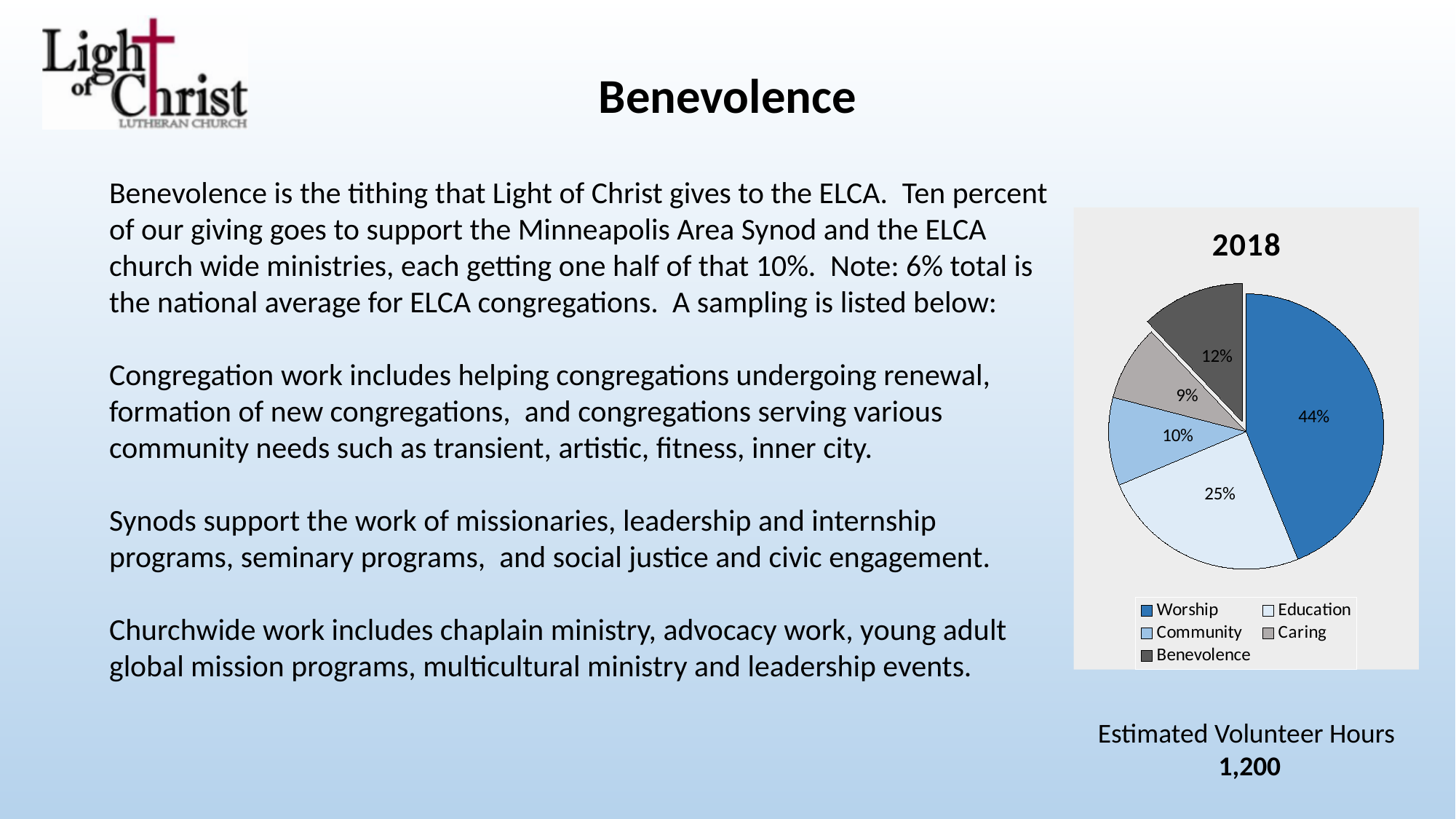
Which category has the smallest slice of the pie? Caring What share of the pie does Benevolence represent? 12% What type of chart is shown on the slide? pie chart What share of the pie does Caring represent? 9% What is the title of the pie chart? 2018 Which is larger, the Benevolence slice or the Community slice? Benevolence What share of the pie does Education represent? 25% How many categories does the legend of the pie chart list? 5 What is the difference in percentage points between Worship and Education? 19 Which category has the largest slice of the pie? Worship